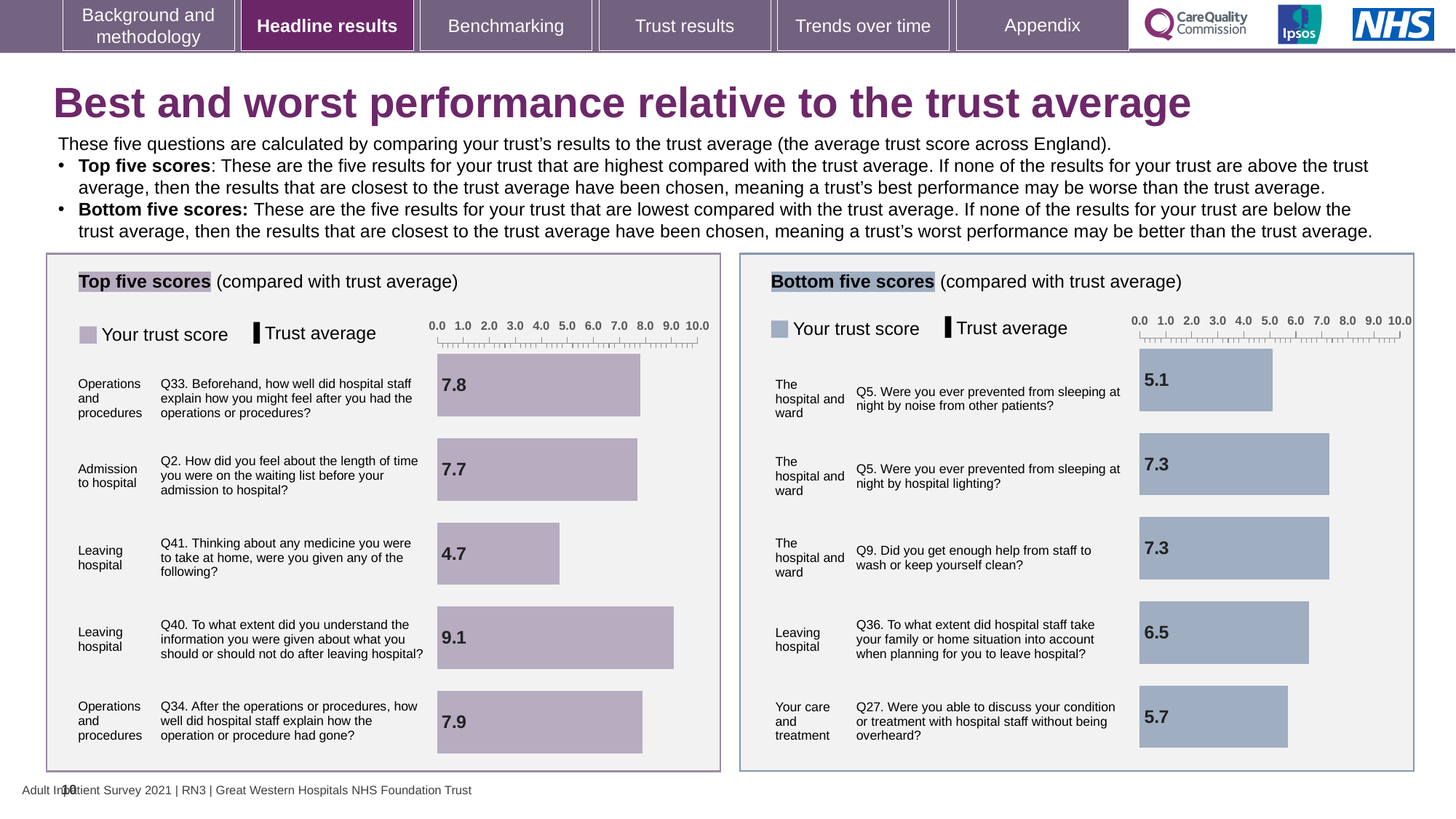
In the Bottom five scores chart, what is the trust score for Q5 about being prevented from sleeping at night by noise from other patients? 5.1 In the Bottom five scores chart, what is the trust score for Q36 about staff taking family or home situation into account when planning to leave hospital? 6.5 In the Top five scores chart, which question has the highest trust score? Q40 In the Top five scores chart, which question has the lowest trust score? Q41 In the Bottom five scores chart, what is the difference between the scores for Q9 and Q27? 1.6 In the Top five scores chart, what is the difference between the scores for Q40 and Q41? 4.4 In the Top five scores chart, what is the trust score for Q40 about understanding the information given about what to do after leaving hospital? 9.1 What type of chart is used for the Top five scores? Bar chart How many bars are plotted in the Bottom five scores chart? 5 In the Bottom five scores chart, which has the larger trust score: Q36 or Q27? Q36 In the Top five scores chart, what is the trust score for Q41 about medicine to take at home? 4.7 In the Bottom five scores chart, which question has the lowest trust score? Q5 (prevented from sleeping by noise from other patients)